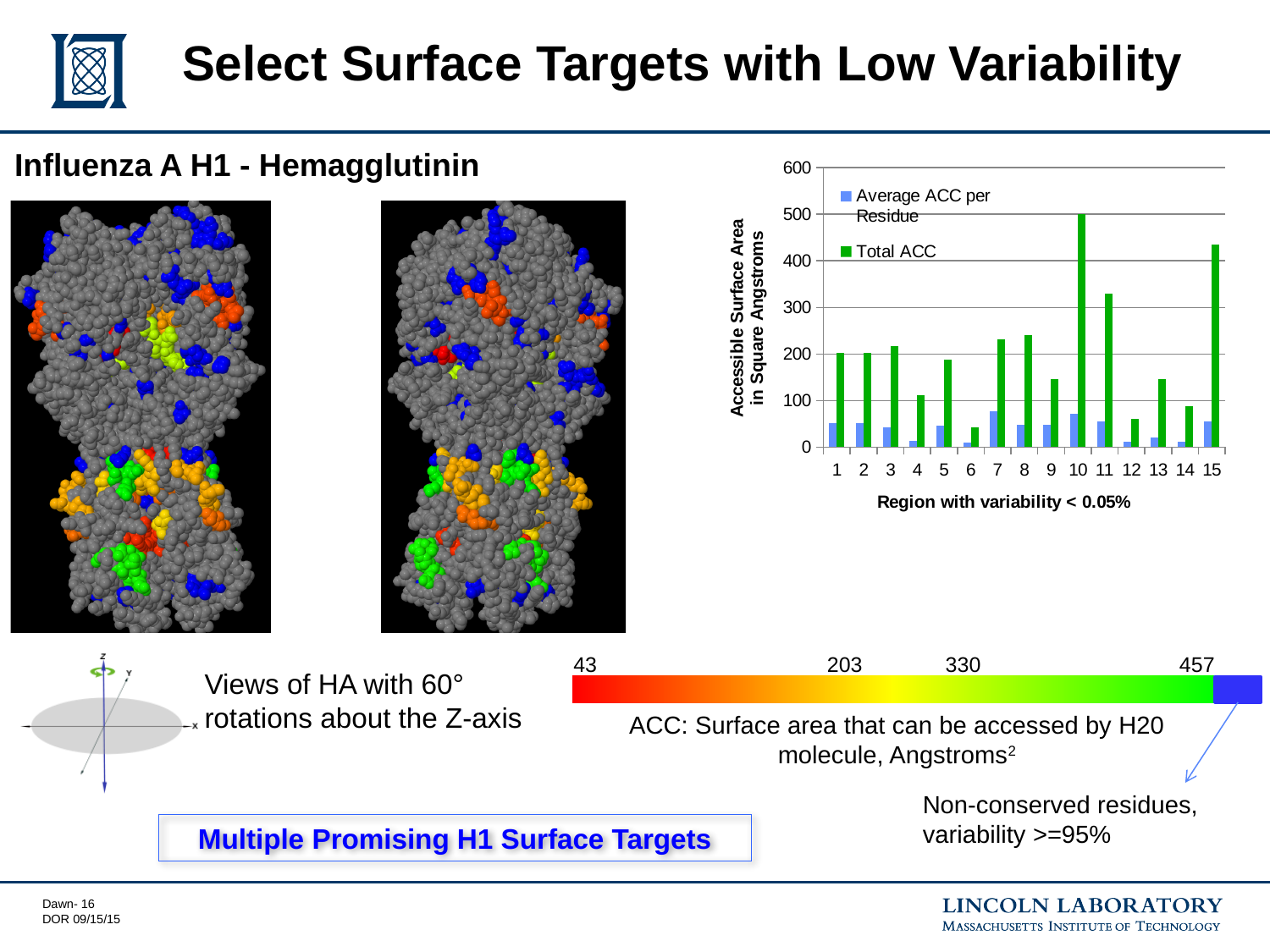
Which has the larger Total ACC, region 10 or region 15? region 10 Is the Total ACC for region 10 greater or less than 400? greater Is the Total ACC for region 11 greater or less than 300? greater How many series does the chart legend list? 2 Which has the larger Total ACC, region 7 or region 11? region 11 Which region has the lowest Total ACC? 6 What kind of chart is shown on the slide? bar chart Is the Total ACC for region 6 greater or less than 100? less Which region has the highest Total ACC? 10 What is the title of the x axis of the chart? Region with variability < 0.05% How many regions are shown along the x axis of the chart? 15